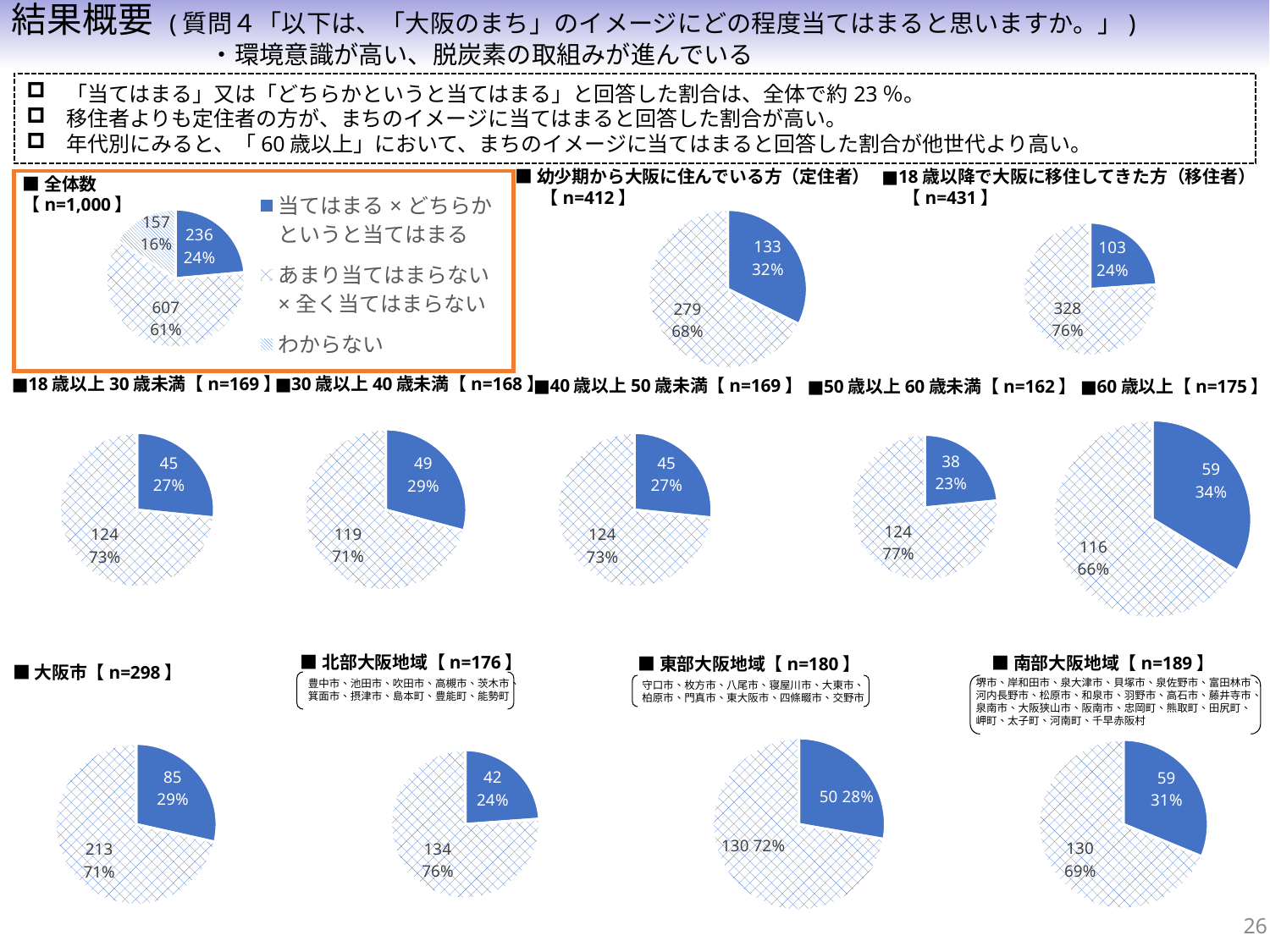
In the 18歳以降で大阪に移住してきた方（移住者） chart, what is the count for the larger slice? 328 How many entries does the legend in the 全体数 chart list? 3 In the 全体数 chart, what percentage share is shown for わからない? 16% In the 全体数 chart, what is the count for 当てはまる×どちらかというと当てはまる? 236 Among the five age-group charts (18歳以上30歳未満 to 60歳以上), which has the highest percentage for 当てはまる×どちらかというと当てはまる? 60歳以上 What kind of chart is used for the 幼少期から大阪に住んでいる方（定住者） data? Pie chart In the 60歳以上 chart, what is the difference between the two slice counts (116 and 59)? 57 Which of the two charts, 定住者 or 移住者, shows a larger percentage for 当てはまる×どちらかというと当てはまる? 定住者 In the 全体数 chart, how many slices does the pie have? 3 In the 幼少期から大阪に住んでいる方（定住者） chart, what percentage is shown for the blue slice (当てはまる×どちらかというと当てはまる)? 32% In the 東部大阪地域 chart, what percentage is shown for the blue slice? 28% Among the five age-group charts, which has the lowest percentage for 当てはまる×どちらかというと当てはまる? 50歳以上60歳未満